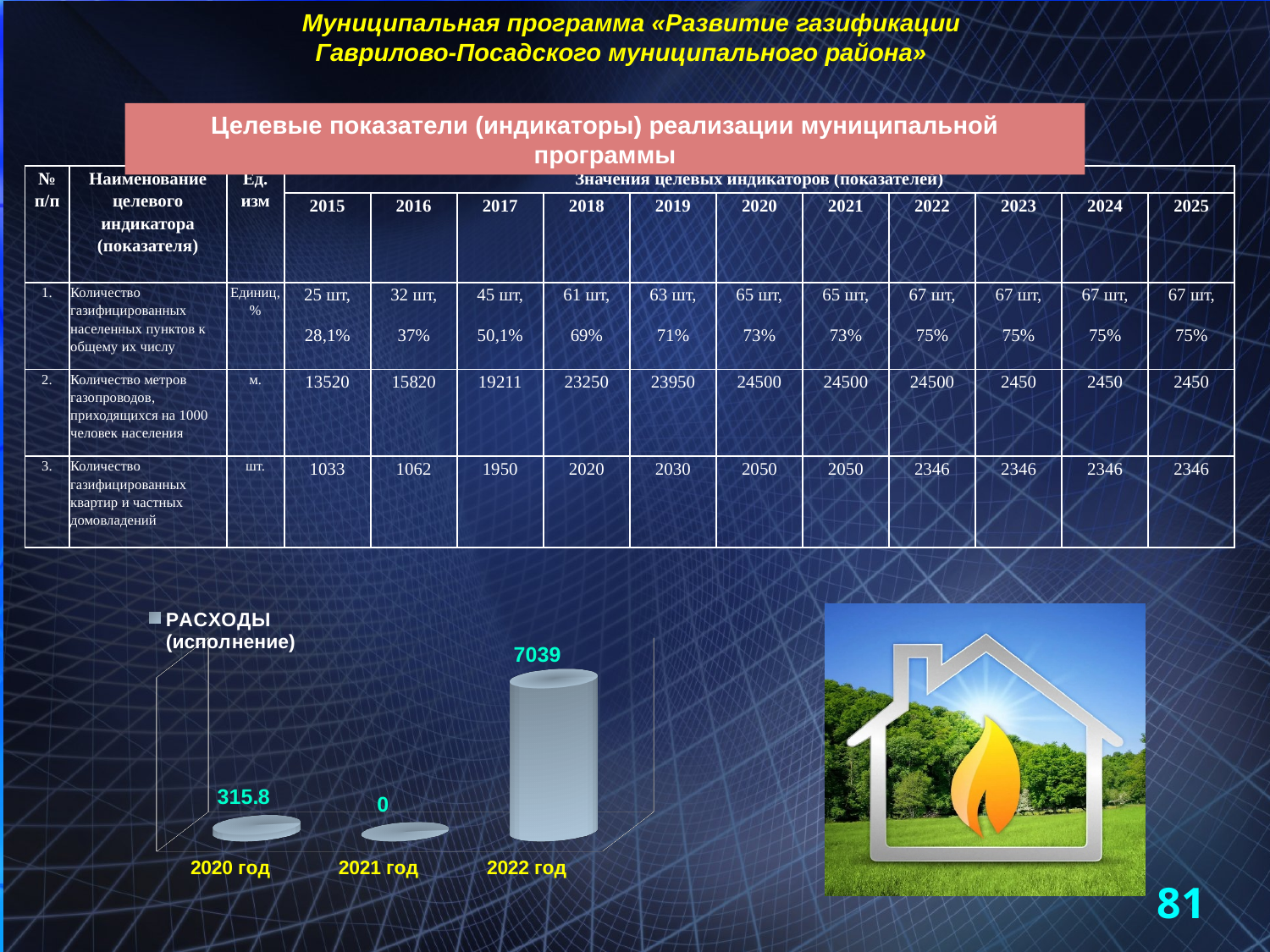
What is the value for 2022 год in the РАСХОДЫ (исполнение) chart? 7039 How many series does the legend of the chart at the bottom of the slide list? 1 What is the value for 2020 год in the РАСХОДЫ (исполнение) chart? 315.8 In the РАСХОДЫ (исполнение) chart, what is the difference between the values for 2022 год and 2020 год? 6723.2 Which year has the lowest value in the РАСХОДЫ (исполнение) chart? 2021 год What is the value for 2021 год in the РАСХОДЫ (исполнение) chart? 0 What kind of chart is shown at the bottom left of the slide? Bar chart Which year has the highest value in the РАСХОДЫ (исполнение) chart? 2022 год In the РАСХОДЫ (исполнение) chart, which is larger: the value for 2020 год or the value for 2021 год? 2020 год What is the legend entry of the chart at the bottom left of the slide? РАСХОДЫ (исполнение) In the РАСХОДЫ (исполнение) chart, what is the total of the values for 2020 год, 2021 год and 2022 год? 7354.8 How many categories (years) are shown in the РАСХОДЫ (исполнение) chart? 3